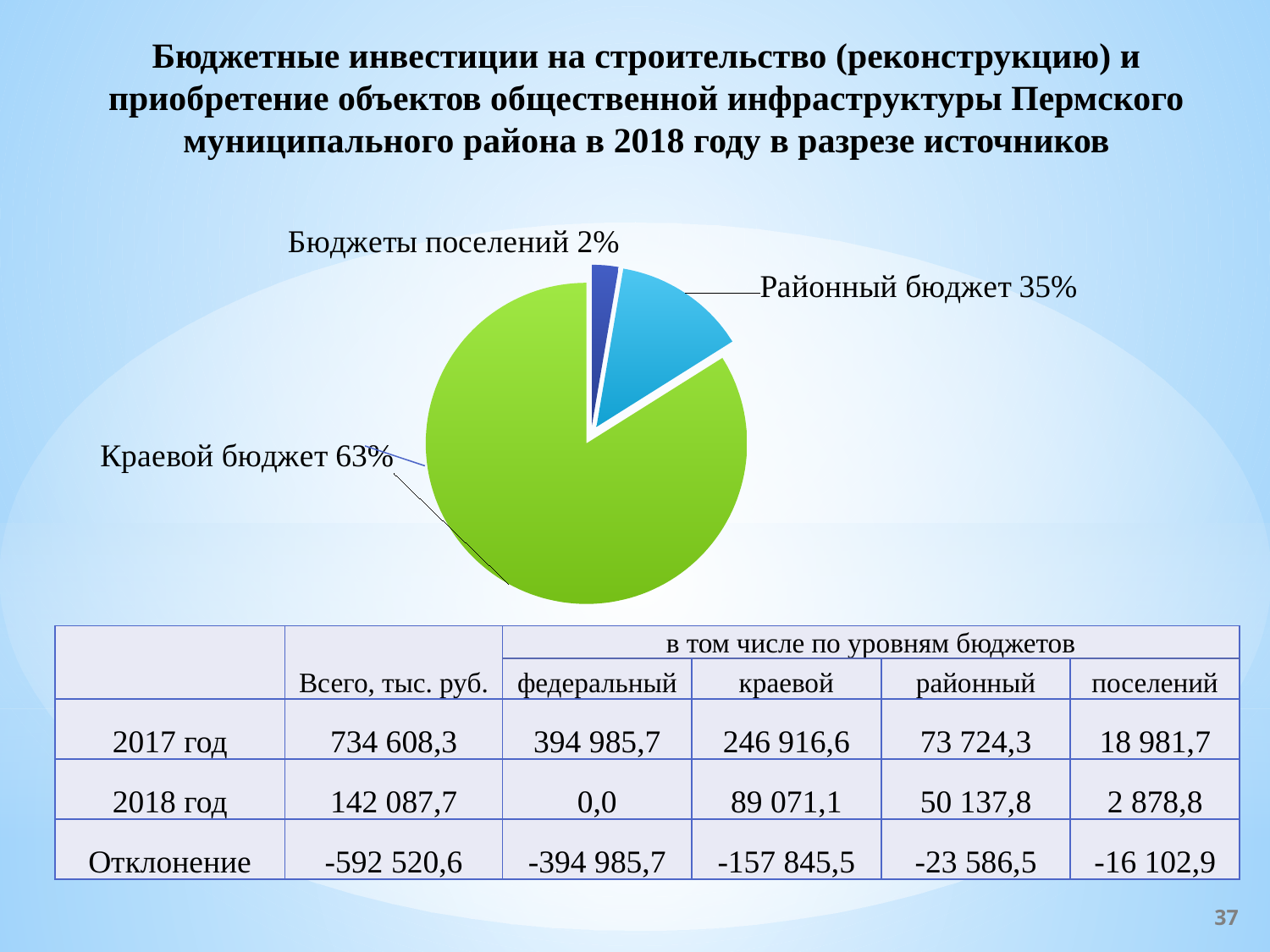
Which year does the pie chart on the slide describe, according to the title? 2018 What colour is the Краевой бюджет slice in the pie chart? Green What type of chart is shown on the slide? Pie chart How many slices does the pie chart have? 3 What is the difference in percentage points between the Краевой бюджет slice and the Районный бюджет slice? 28 Which slice is larger: Районный бюджет or Бюджеты поселений? Районный бюджет What share of the pie chart does Краевой бюджет represent? 63% What is the combined share of Районный бюджет and Бюджеты поселений in the pie chart? 37% What share of the pie chart does Бюджеты поселений represent? 2% Which source has the largest slice in the pie chart? Краевой бюджет Which source has the smallest slice in the pie chart? Бюджеты поселений What share of the pie chart does Районный бюджет represent? 35%